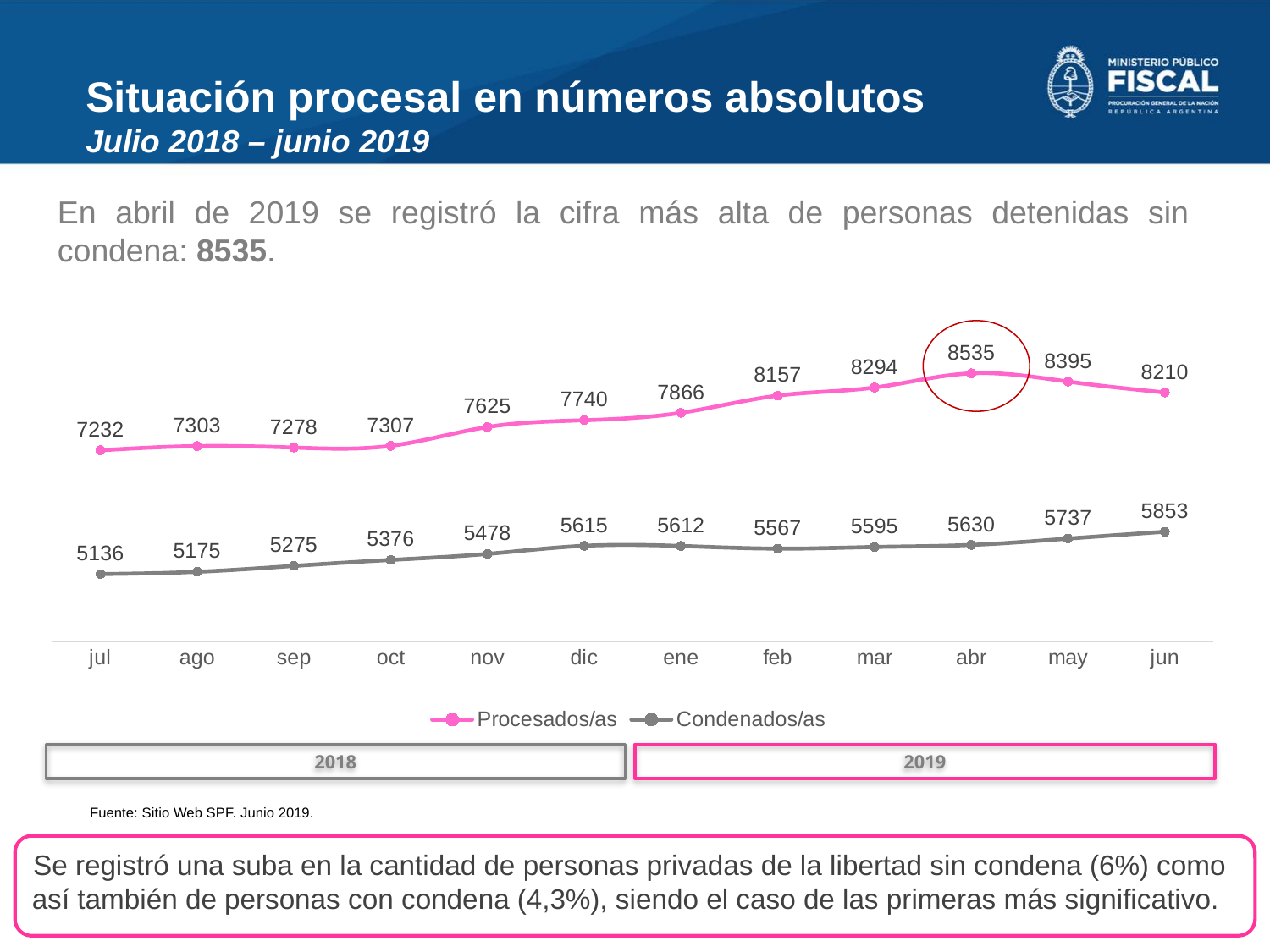
What kind of chart is shown on the slide? line chart What is the difference between Procesados/as and Condenados/as in jun? 2357 In which month is the Procesados/as series highest? abr Which is larger, the Condenados/as value in dic or in ene? dic In which month is the Condenados/as series lowest? jul Does the Condenados/as series rise or fall from jul to jun overall? rise How many months are shown on the x axis? 12 What is the difference between the Procesados/as values in abr and jul? 1303 What is the value for Condenados/as in jul? 5136 What is the value for Condenados/as in jun? 5853 How many series does the legend list? 2 What is the value for Procesados/as in abr? 8535